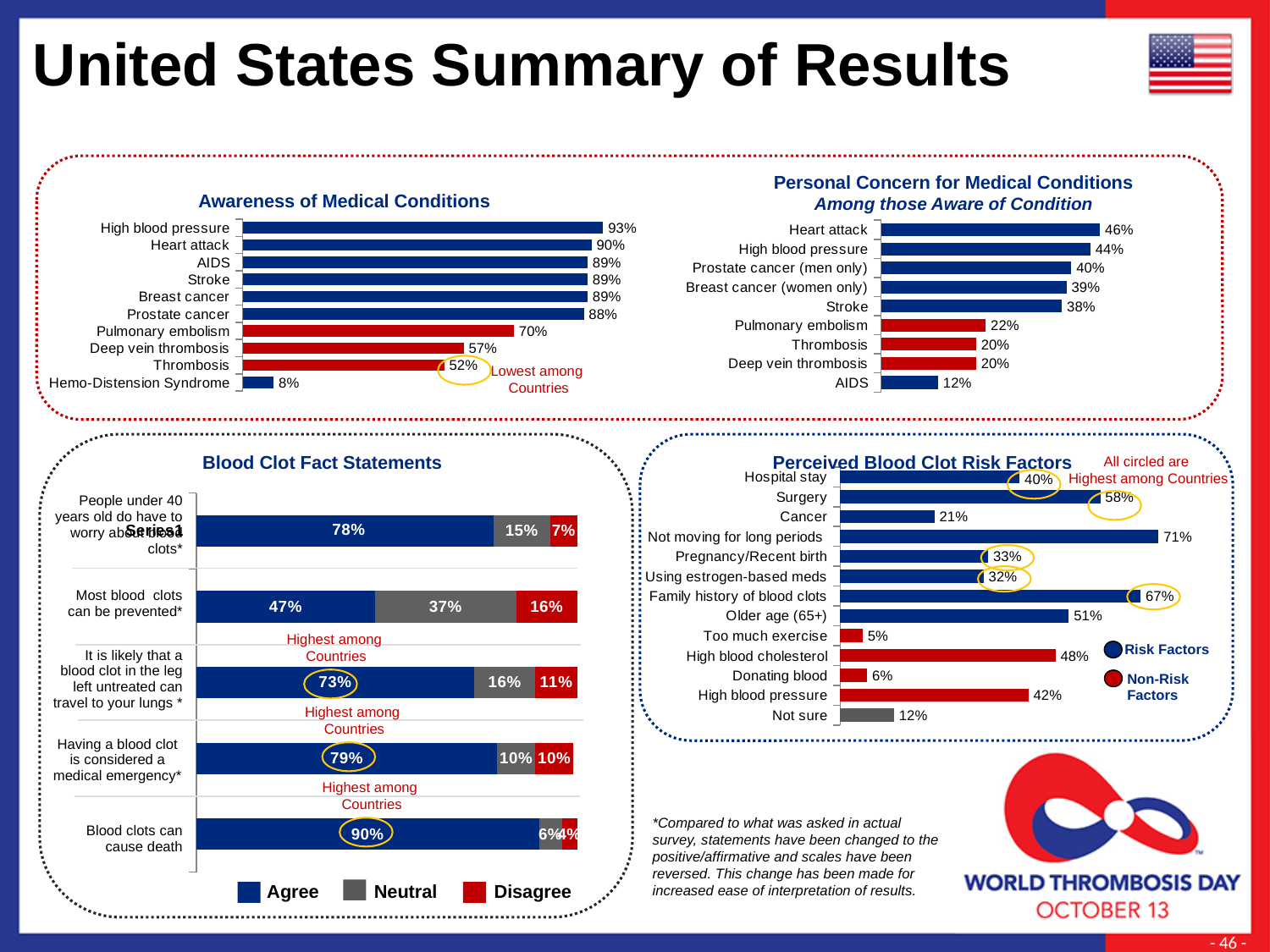
What type of chart is the Perceived Blood Clot Risk Factors chart? Bar chart How many conditions are listed in the Awareness of Medical Conditions chart? 10 In the Personal Concern for Medical Conditions chart, which condition has the highest value? Heart attack In the Perceived Blood Clot Risk Factors chart, which factor has the lowest value? Too much exercise In the Awareness of Medical Conditions chart, what is the difference between High blood pressure and Thrombosis? 41% In the Blood Clot Fact Statements chart, what percentage agree that most blood clots can be prevented? 47% In the Personal Concern for Medical Conditions chart, what is the value for Stroke? 38% In the Personal Concern for Medical Conditions chart, which is larger: Pulmonary embolism or AIDS? Pulmonary embolism How many series does the legend of the Blood Clot Fact Statements chart list? 3 In the Perceived Blood Clot Risk Factors chart, what is the value for Not moving for long periods? 71% In the Awareness of Medical Conditions chart, which condition has the lowest awareness? Hemo-Distension Syndrome In the Awareness of Medical Conditions chart, what is the value for Pulmonary embolism? 70%